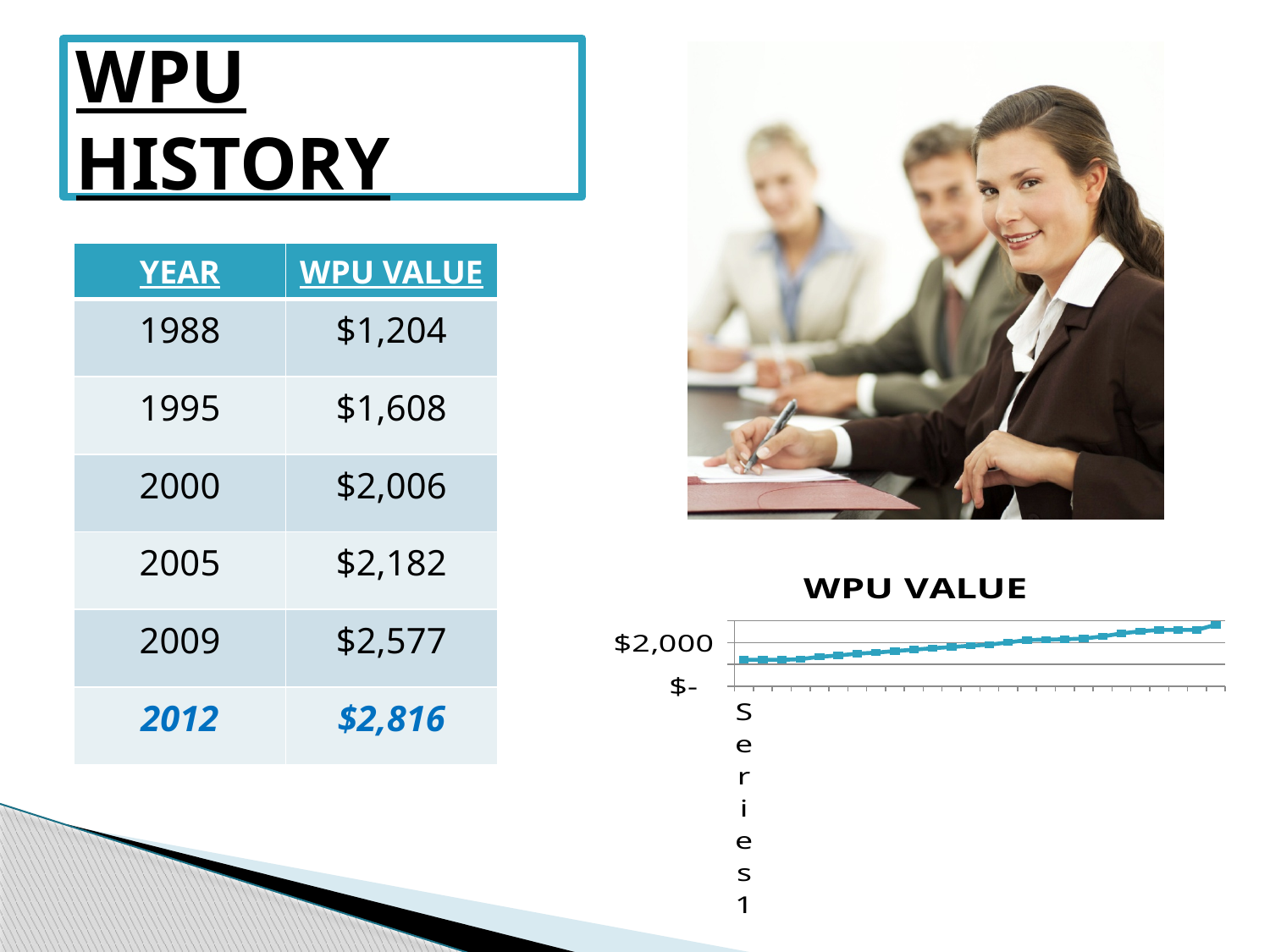
In the "WPU VALUE" chart, is the value of the leftmost point greater or less than $2,000? less What kind of chart is shown under the title "WPU VALUE"? line chart In the "WPU VALUE" chart, is the value of the rightmost point greater or less than $2,000? greater What is the title of the chart on the slide? WPU VALUE What is the highest value labelled on the y axis of the "WPU VALUE" chart? $2,000 Do the values in the "WPU VALUE" chart rise or fall from left to right along the x axis? rise In the "WPU VALUE" chart, which point is higher: the leftmost point or the rightmost point? the rightmost point